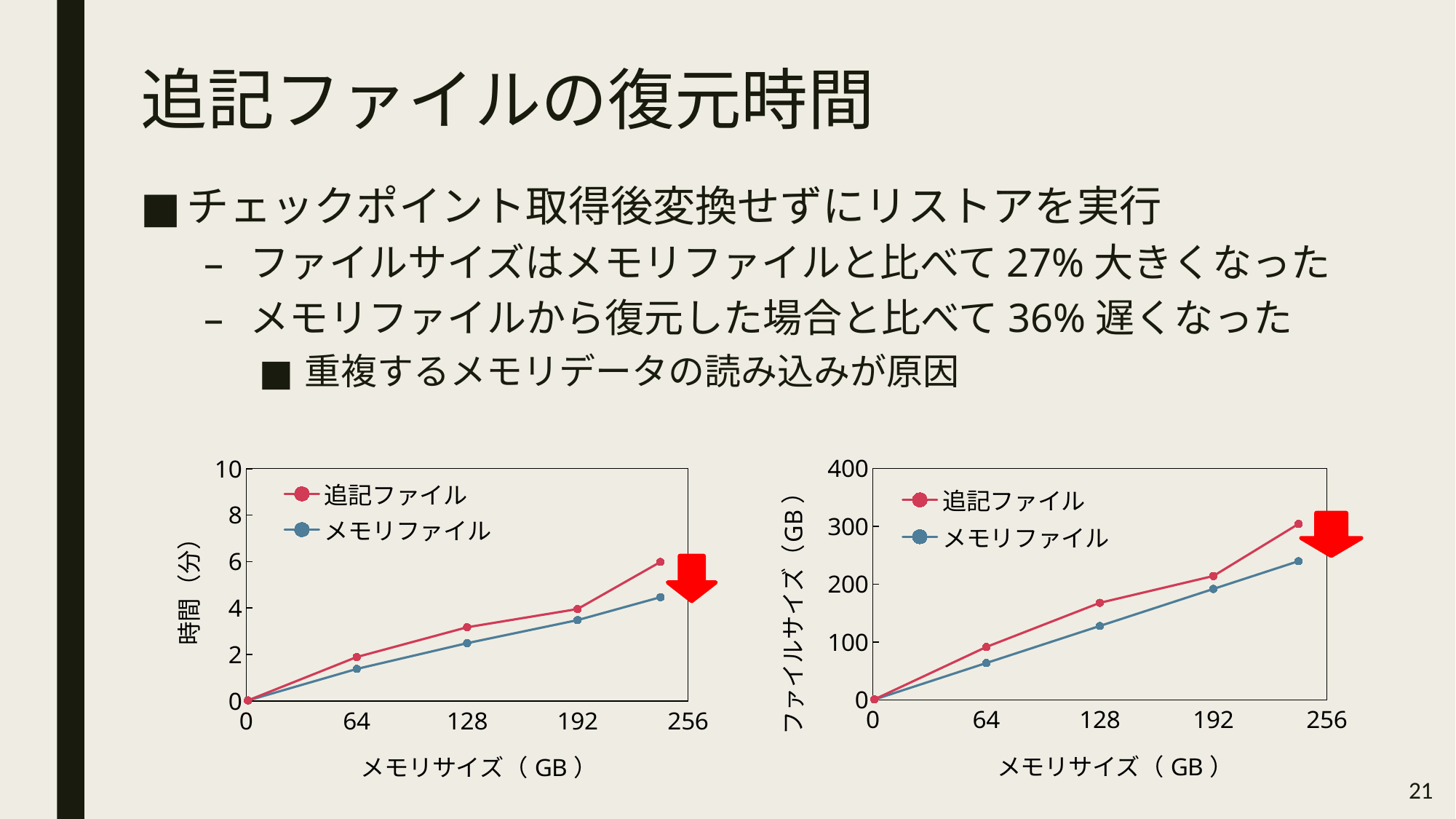
In the right chart (ファイルサイズ), is the value for 追記ファイル at 128 GB greater or less than 100? greater In the right chart (ファイルサイズ), which series is higher at 192 GB, 追記ファイル or メモリファイル? 追記ファイル In the left chart (時間), is the value for 追記ファイル at 128 GB greater or less than 2? greater In the left chart (時間), how many data points does the 追記ファイル series have? 5 What is the y-axis label of the right chart? ファイルサイズ（GB） What colour is the 追記ファイル line in the left chart? red In the left chart (時間), which series is higher at 128 GB, 追記ファイル or メモリファイル? 追記ファイル In the left chart (時間), do the values of 追記ファイル rise or fall as メモリサイズ increases? rise What kind of chart is the left chart (時間 vs メモリサイズ)? line chart How many series does the legend of the right chart (ファイルサイズ) list? 2 In the left chart (時間), is the value for メモリファイル at 64 GB greater or less than 2? less